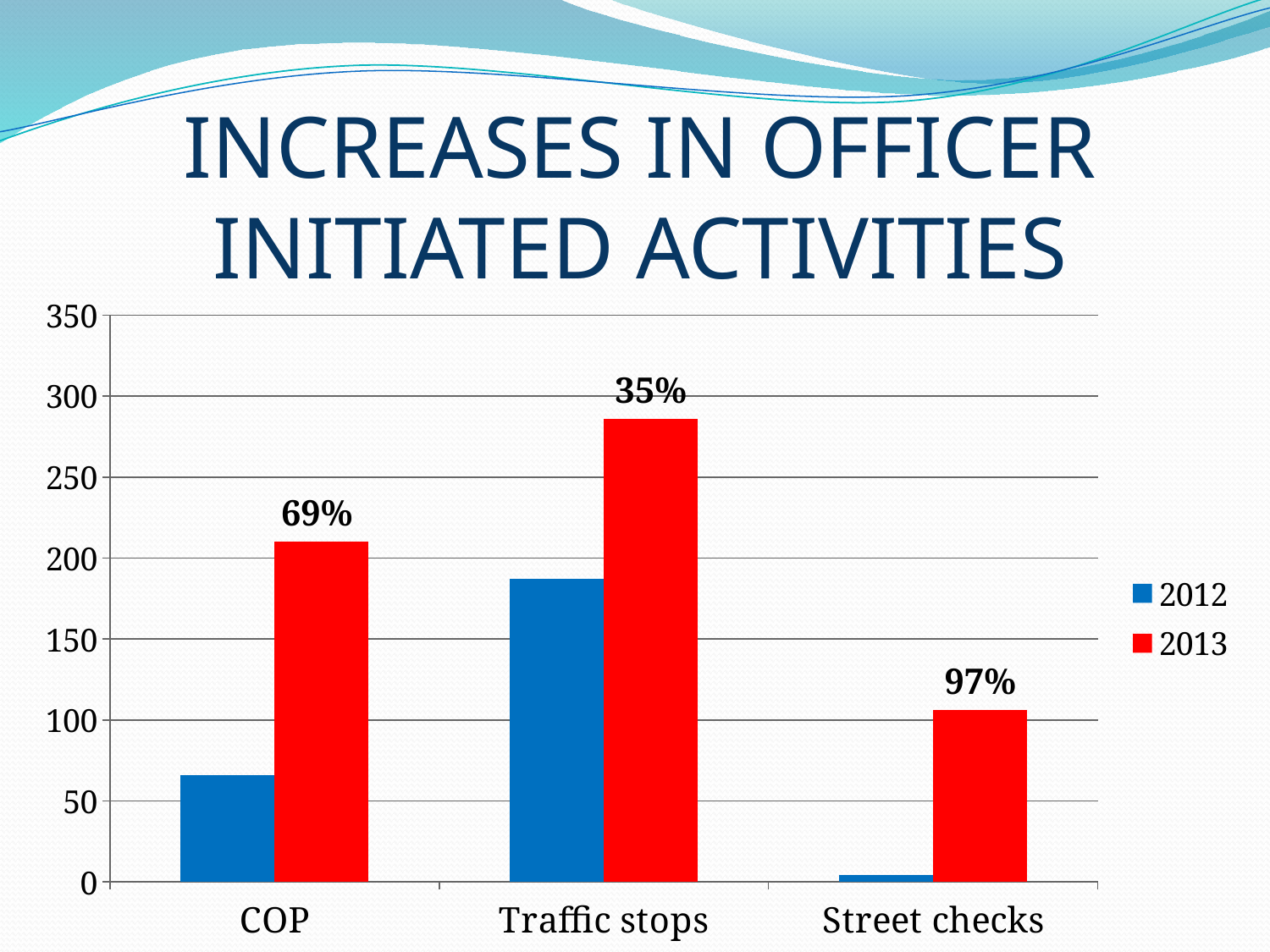
How many categories are shown on the x axis? 3 What kind of chart is shown on the slide? bar chart What percentage label is printed above the 2013 bar for COP? 69% What is the title of the chart on the slide? INCREASES IN OFFICER INITIATED ACTIVITIES How many series does the legend list? 2 Which is larger: the 2013 value for COP or the 2012 value for Traffic stops? 2013 value for COP Which category has the lowest 2012 value? Street checks Which category has the highest 2013 value? Traffic stops Is the 2013 value for Traffic stops greater or less than 250? greater What percentage label is printed above the 2013 bar for Traffic stops? 35% Is the 2012 value for COP greater or less than 100? less What percentage label is printed above the 2013 bar for Street checks? 97%